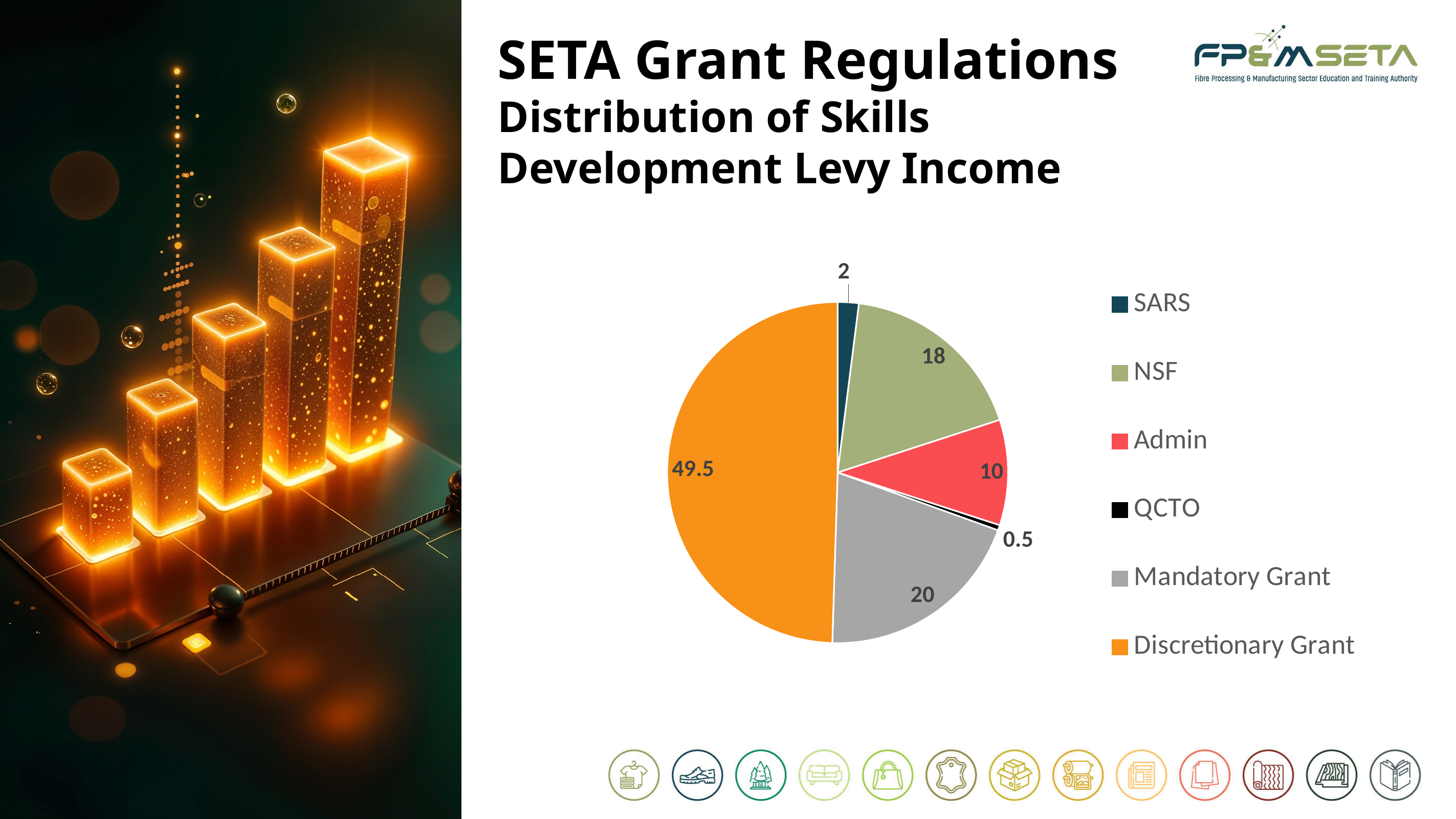
What is the value for QCTO? 0.5 What colour is the Discretionary Grant slice? Orange How many categories does the pie chart have? 6 Which is larger, the value for NSF or the value for Mandatory Grant? Mandatory Grant What is the total of all the slice values in the pie chart? 100 What is the value for Discretionary Grant? 49.5 What kind of chart is shown on the slide? Pie chart Which category has the smallest slice of the pie? QCTO Which category has the largest slice of the pie? Discretionary Grant What is the value for SARS? 2 What is the value for NSF? 18 What is the difference between the values for Mandatory Grant and Admin? 10